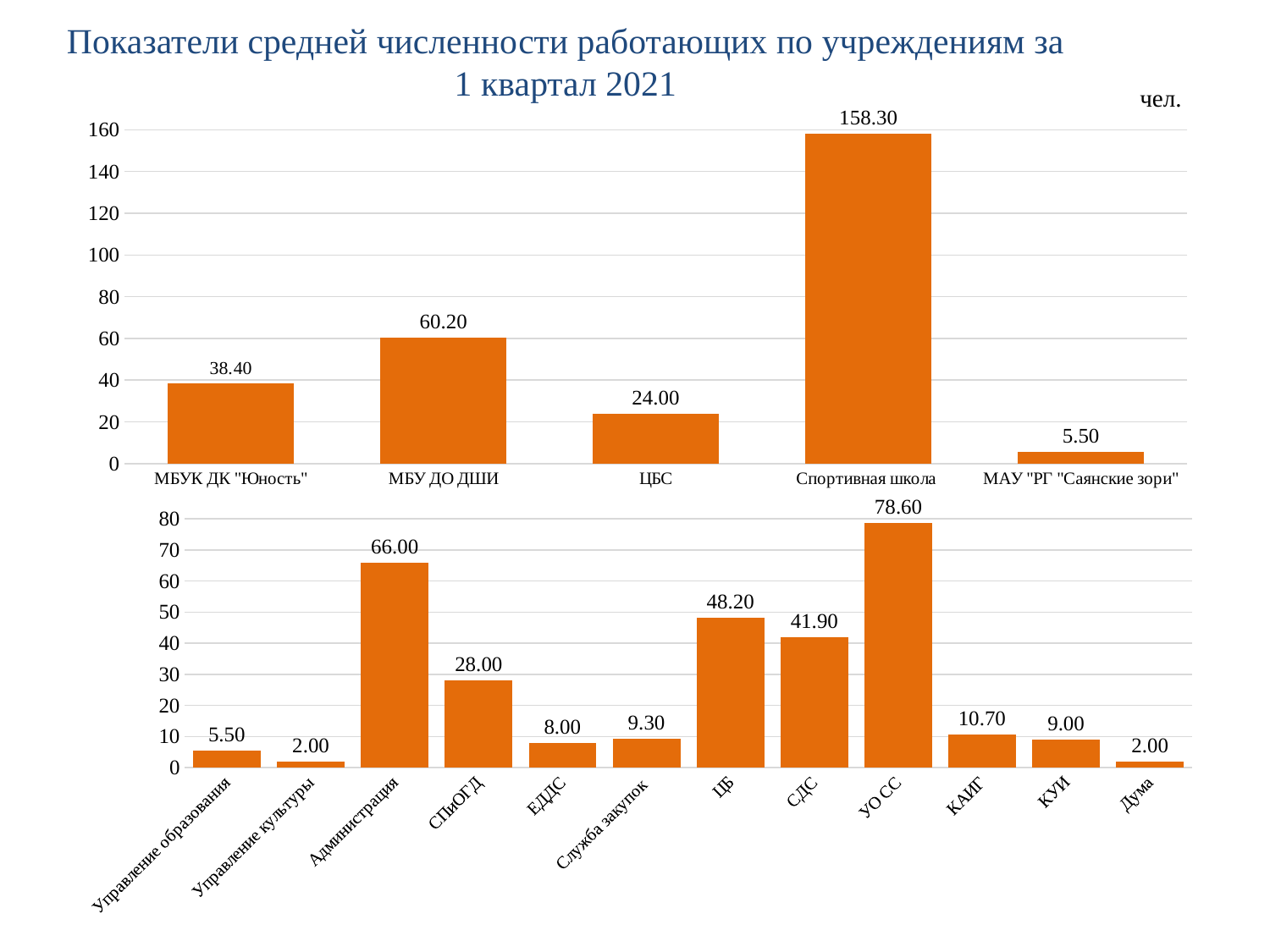
In the bottom chart, which is larger, ЦБ or СДС? ЦБ In the top chart, what is the value for Спортивная школа? 158.30 In the top chart, how many categories are shown? 5 In the bottom chart, what is the value for КАИГ? 10.70 In the bottom chart, which category has the highest value? УО СС In the bottom chart, how many categories are shown? 12 In the bottom chart, what is the value for Администрация? 66.00 In the top chart, which category has the lowest value? МАУ "РГ "Саянские зори" In the top chart, what is the difference between МБУ ДО ДШИ and МБУК ДК "Юность"? 21.80 In the top chart, what is the value for ЦБС? 24.00 What type of chart is the top chart? Bar chart In the bottom chart, what is the difference between УО СС and Администрация? 12.60